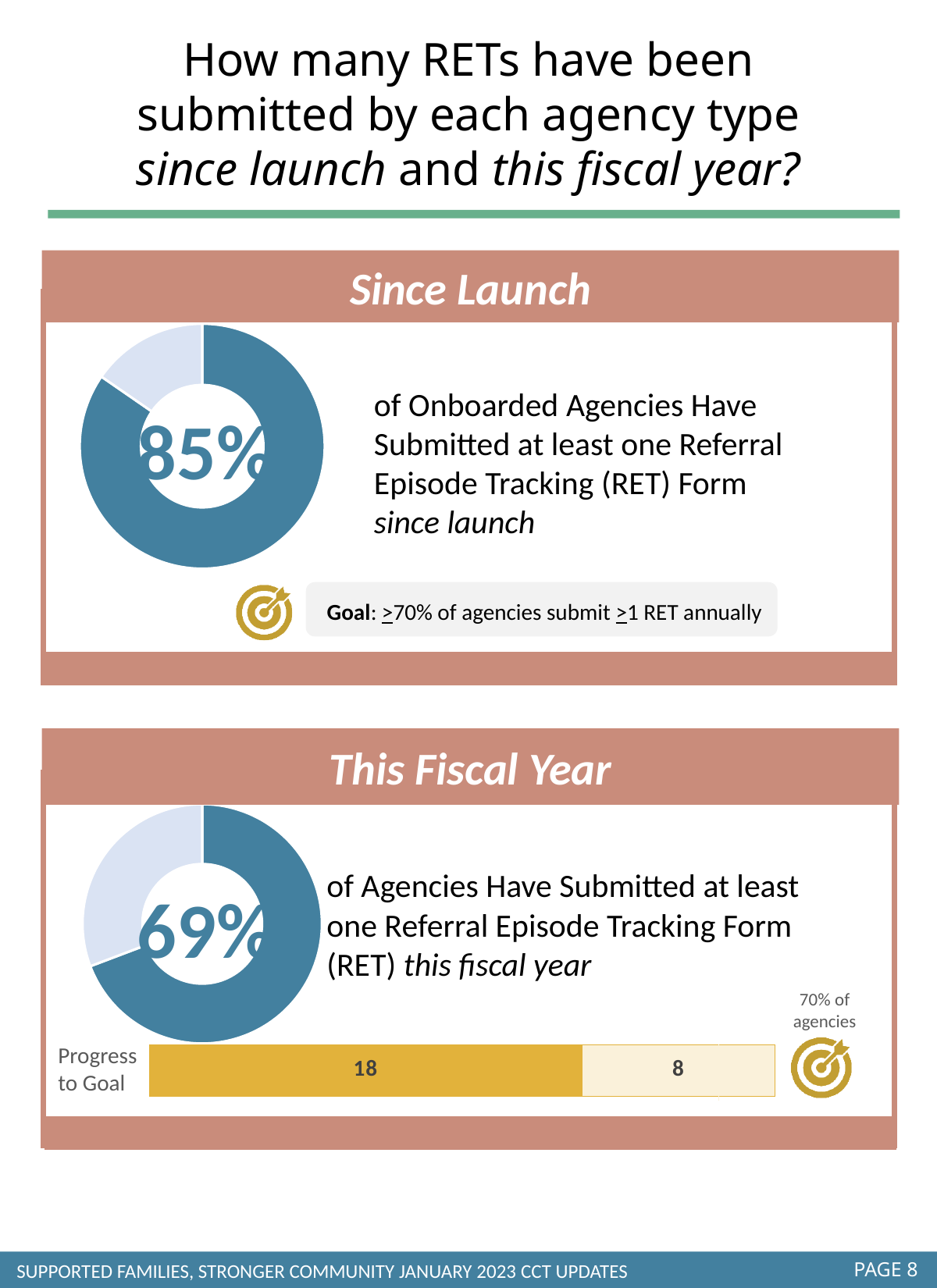
What kind of chart is used in the Since Launch section to show the 85% figure? Donut (pie) chart In the Progress to Goal bar, what is the value of the lighter segment? 8 What kind of chart is the Progress to Goal chart in the This Fiscal Year section? Bar chart What is the total of the two segments in the Progress to Goal bar? 26 Is the This Fiscal Year donut value greater or less than the 70% goal shown on the slide? less In the Since Launch donut chart, what percentage of onboarded agencies have submitted at least one RET form? 85% What is the difference between the two segments in the Progress to Goal bar? 10 In the Progress to Goal bar, which segment is larger, the darker one or the lighter one? The darker one (18) By how many percentage points does the Since Launch percentage exceed the This Fiscal Year percentage? 16 percentage points In the Progress to Goal bar, what is the value of the darker filled segment? 18 Which donut chart shows the higher percentage, Since Launch or This Fiscal Year? Since Launch In the This Fiscal Year donut chart, what percentage of agencies have submitted at least one RET form? 69%